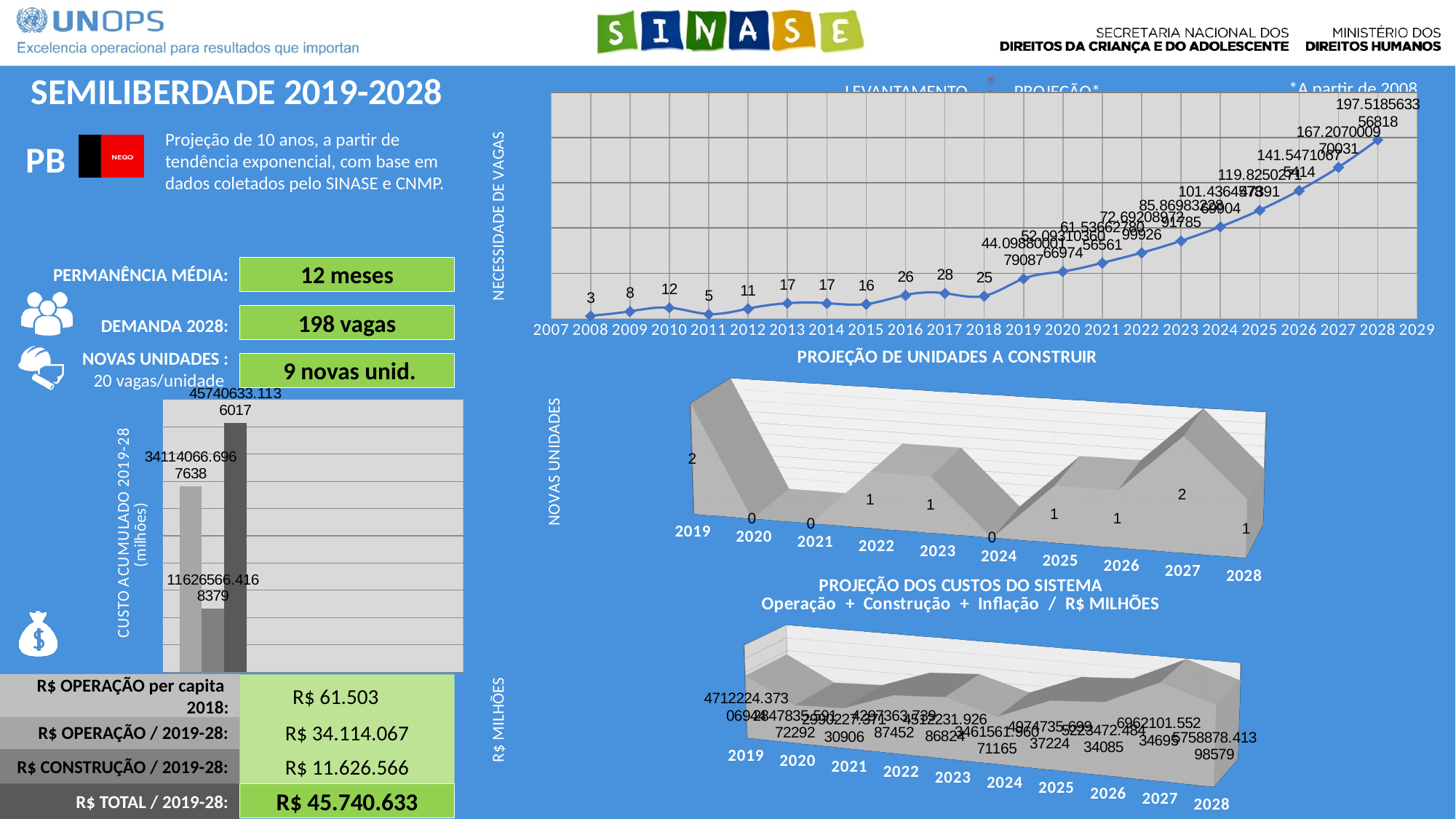
In the NECESSIDADE DE VAGAS line chart, what is the value for 2018? 25 In the NECESSIDADE DE VAGAS line chart, which year has the lowest value? 2008 In the PROJEÇÃO DE UNIDADES A CONSTRUIR chart, what is the value for 2019? 2 In the NECESSIDADE DE VAGAS line chart, do the values generally rise or fall from 2019 to 2028? rise In the NECESSIDADE DE VAGAS line chart, what is the difference between the values for 2017 and 2016? 2 In the NECESSIDADE DE VAGAS line chart, what is the value for 2008? 3 What kind of chart is the CUSTO ACUMULADO 2019-28 chart on the left of the slide? bar chart In the PROJEÇÃO DE UNIDADES A CONSTRUIR chart, what is the value for 2024? 0 How many years are shown on the x axis of the PROJEÇÃO DE UNIDADES A CONSTRUIR chart? 10 In the NECESSIDADE DE VAGAS line chart, which is larger, the value for 2017 or the value for 2018? 2017 In the NECESSIDADE DE VAGAS line chart, what is the value for 2017? 28